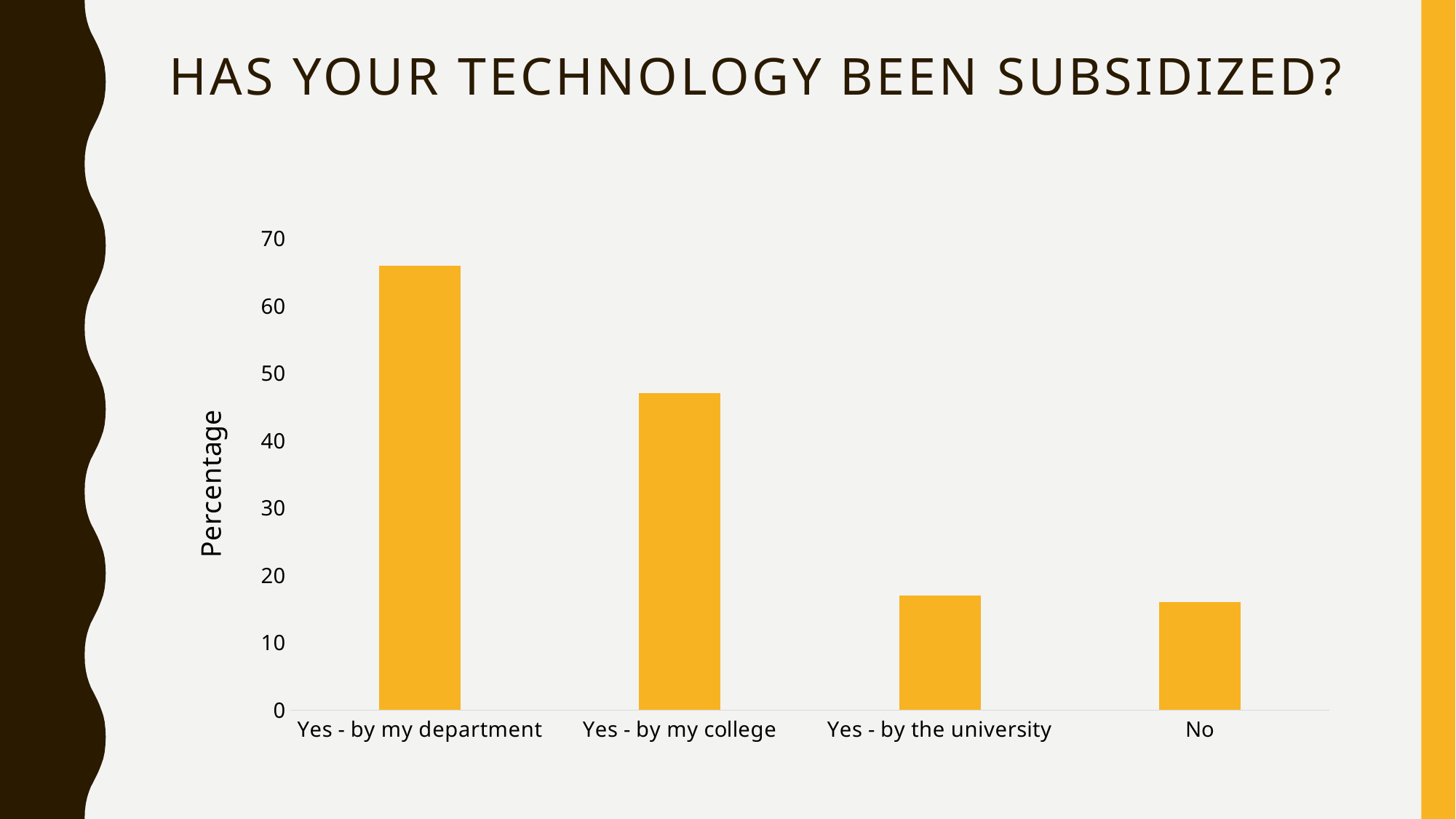
What is the label on the vertical axis? Percentage Is the value for "Yes - by my department" greater or less than 60? greater Is the value for "Yes - by my college" greater or less than 40? greater Is the value for "Yes - by my college" greater or less than 50? less What kind of chart is shown on the slide? bar chart Which is larger, the value for "Yes - by my department" or the value for "Yes - by my college"? Yes - by my department Do the values generally rise or fall from left to right along the x axis? fall Which category has the highest value? Yes - by my department Which is larger, the value for "Yes - by my college" or the value for "No"? Yes - by my college How many categories are shown on the x axis? 4